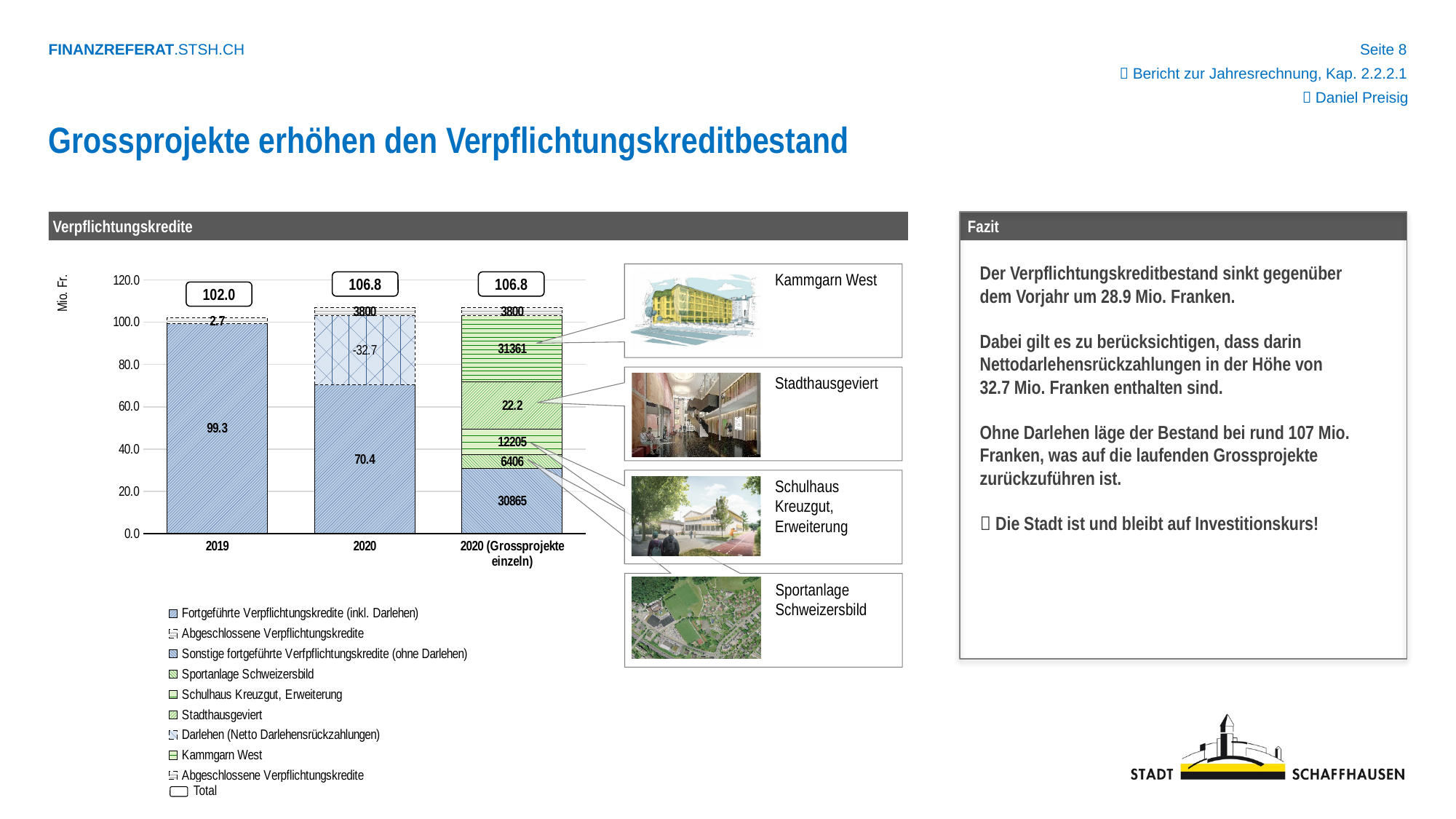
What is the total value shown above the 2020 bar? 106.8 What is the value of the Stadthausgeviert segment in the 2020 (Grossprojekte einzeln) bar? 22.2 What type of chart is shown under the heading "Verpflichtungskredite"? bar chart Which year has the lowest total value: 2019 or 2020? 2019 What is the value of the Fortgeführte Verpflichtungskredite (inkl. Darlehen) segment in 2019? 99.3 What is the total value shown above the 2019 bar? 102.0 What is the value of the large bottom segment of the 2020 bar? 70.4 What unit is shown on the y axis of the Verpflichtungskredite chart? Mio. Fr. What is the difference between the total for 2020 and the total for 2019? 4.8 What value is labelled on the Darlehen (Netto Darlehensrückzahlungen) segment of the 2020 bar? -32.7 How many categories are shown on the x axis of the Verpflichtungskredite chart? 3 What is the value of the Abgeschlossene Verpflichtungskredite segment in 2019? 2.7